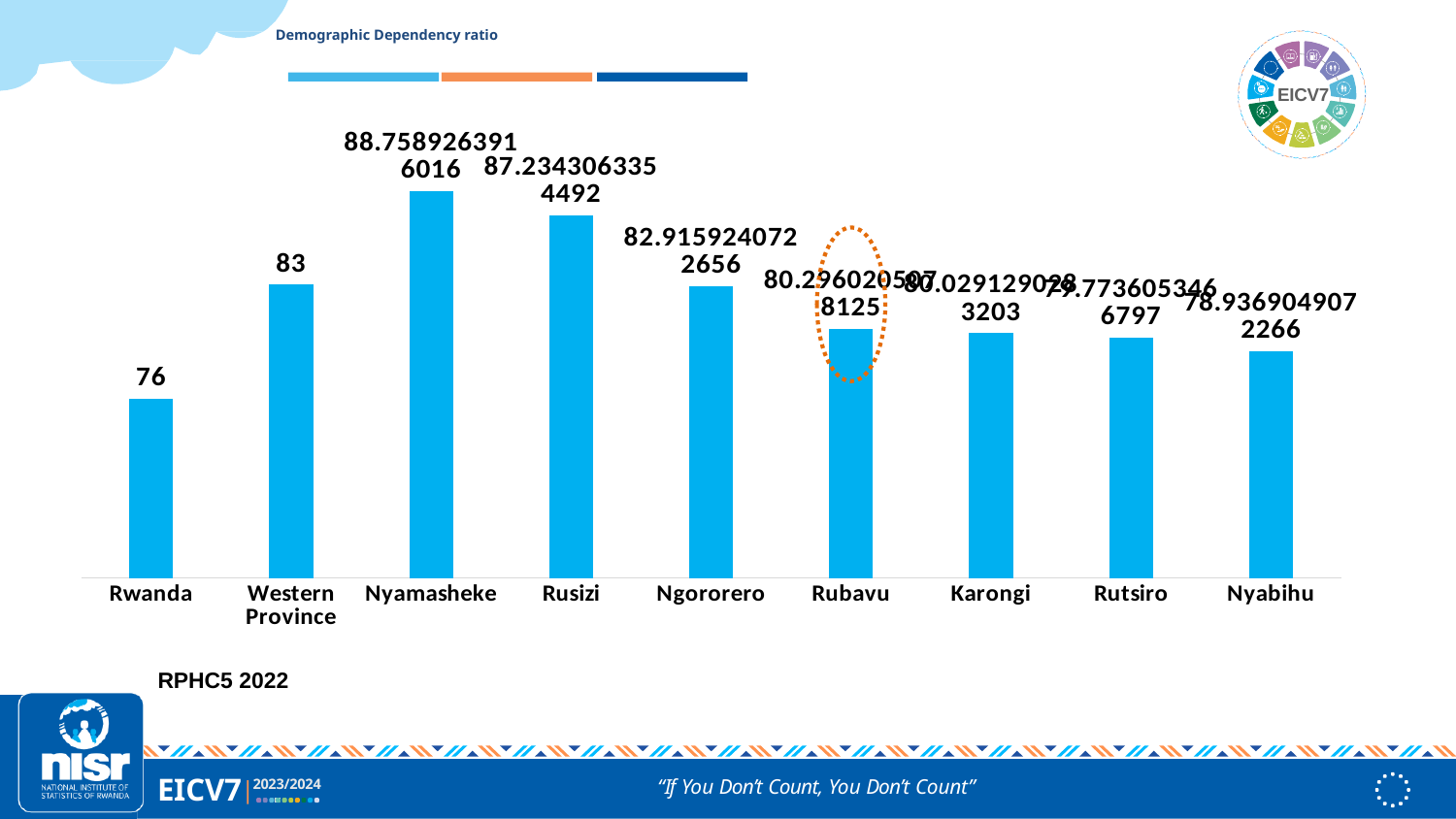
What type of chart is shown on the slide? Bar chart Which category has the lowest value? Rwanda What is the value shown for Nyamasheke? 88.7589263916016 How many categories are shown on the x axis? 9 What is the value for Western Province? 83 Which is larger, the value for Rusizi or the value for Ngororero? Rusizi What is the value shown for Nyabihu? 78.9369049072266 Which category has the highest value? Nyamasheke What is the value for Rwanda? 76 What is the difference between the values for Western Province and Rwanda? 7 What is the value shown for Ngororero? 82.9159240722656 What is the value shown for Rusizi? 87.2343063354492